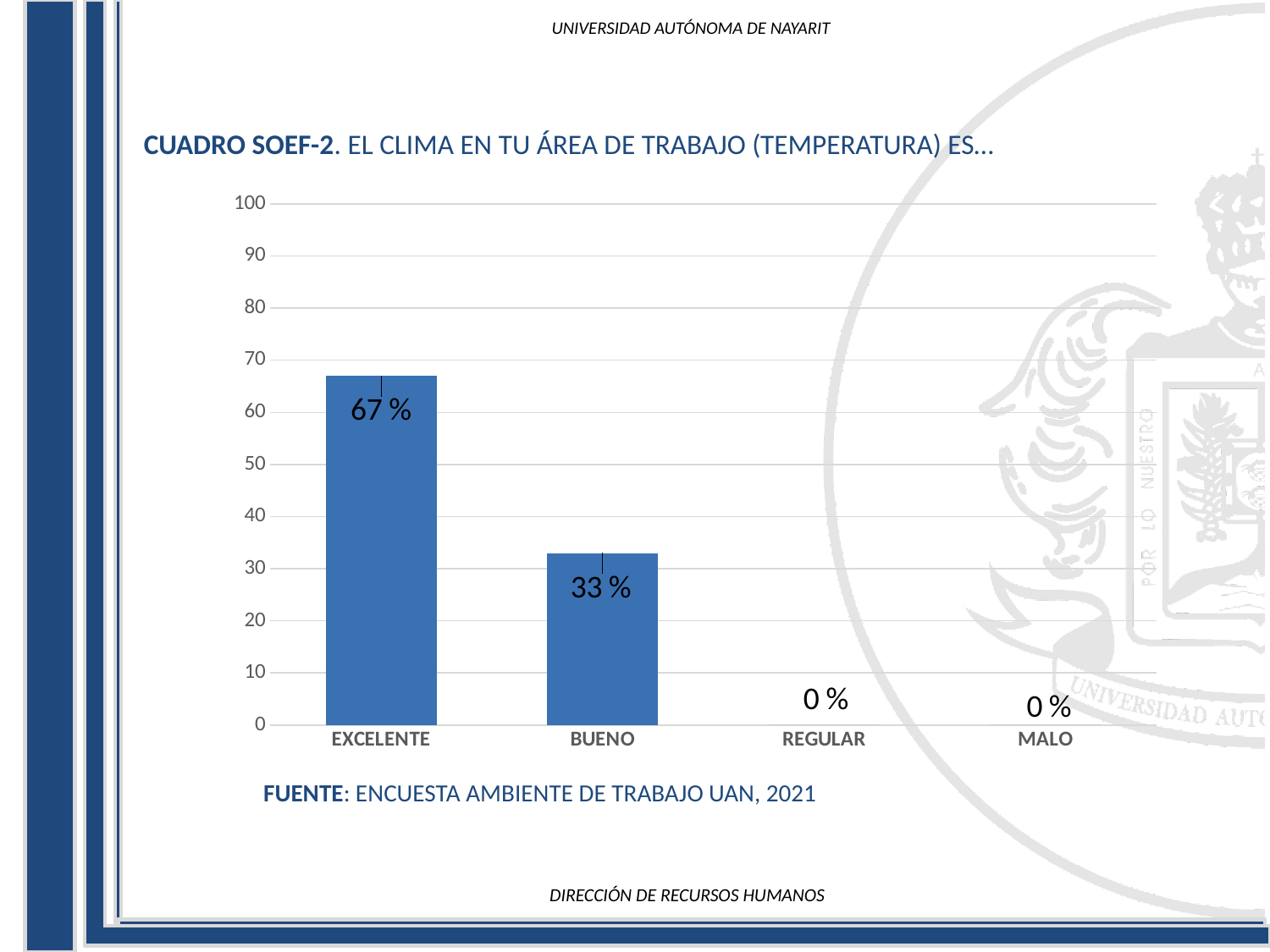
Which category has the highest value? EXCELENTE What is the source cited below the chart? ENCUESTA AMBIENTE DE TRABAJO UAN, 2021 What is the value for REGULAR? 0 % Which is larger, the value for EXCELENTE or the value for BUENO? EXCELENTE Is the value for EXCELENTE greater or less than 60? greater What is the value for EXCELENTE? 67 % Is the value for BUENO greater or less than 40? less What is the difference between the values for EXCELENTE and BUENO? 34 % What kind of chart is shown on the slide? bar chart What is the value for MALO? 0 % How many categories are shown on the x axis? 4 What is the value for BUENO? 33 %